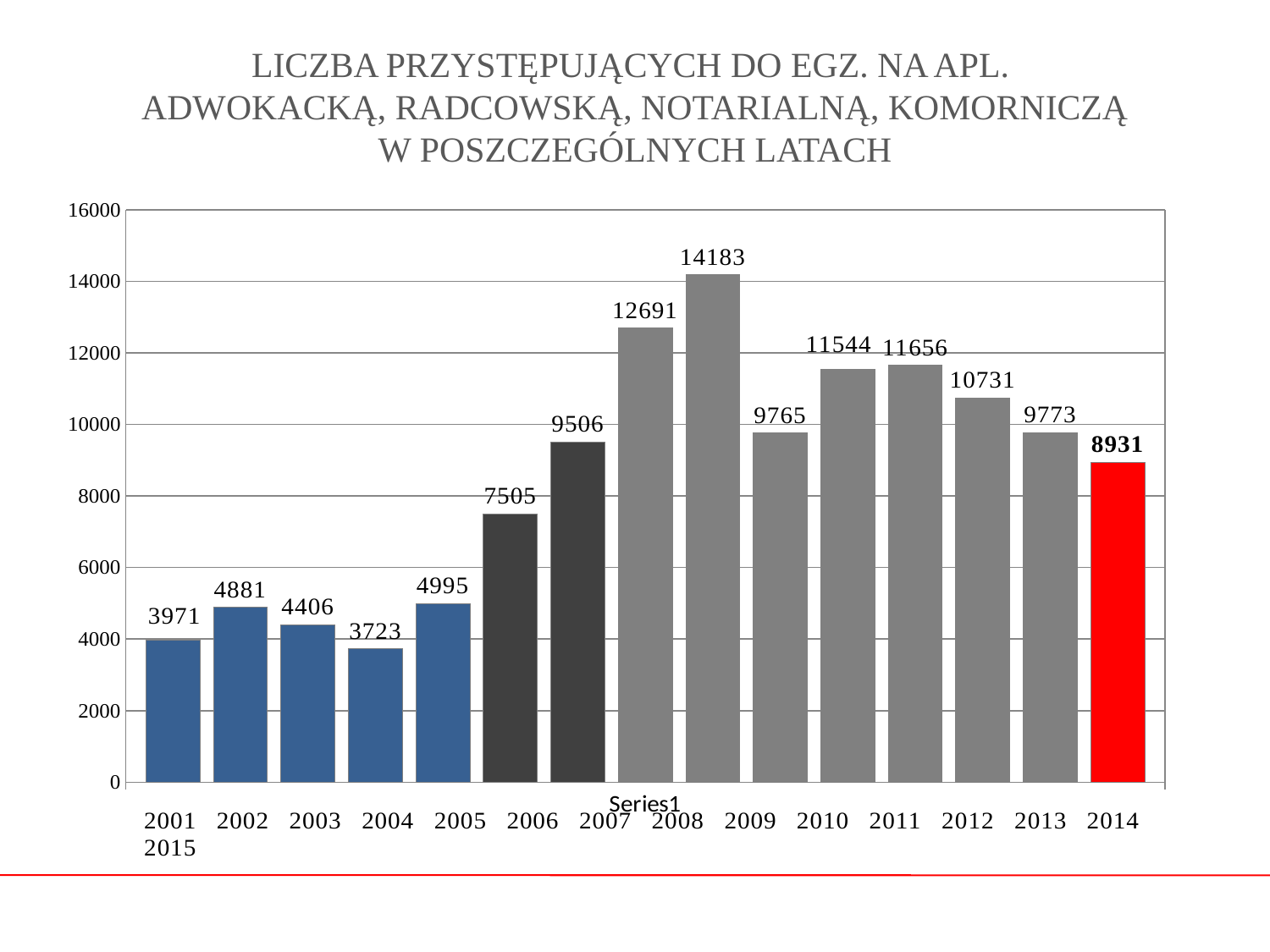
What is the highest value shown in the chart? 14183 Is the value of the red bar greater or less than 10000? less What is the value of the bar labelled 2002? 4881 How many bars are plotted in the chart? 15 What series name is shown below the x axis of the chart? Series1 Which is larger, the bar with value 11544 or the bar with value 11656? 11656 What is the value of the first bar on the left, labelled 2001? 3971 What is the value of the red bar at the right end of the chart? 8931 What is the difference between the highest value (14183) and the lowest value (3723) in the chart? 10460 What is the lowest value shown in the chart? 3723 What kind of chart is shown on the slide? bar chart Do the values of the first five (blue) bars stay below 6000? yes